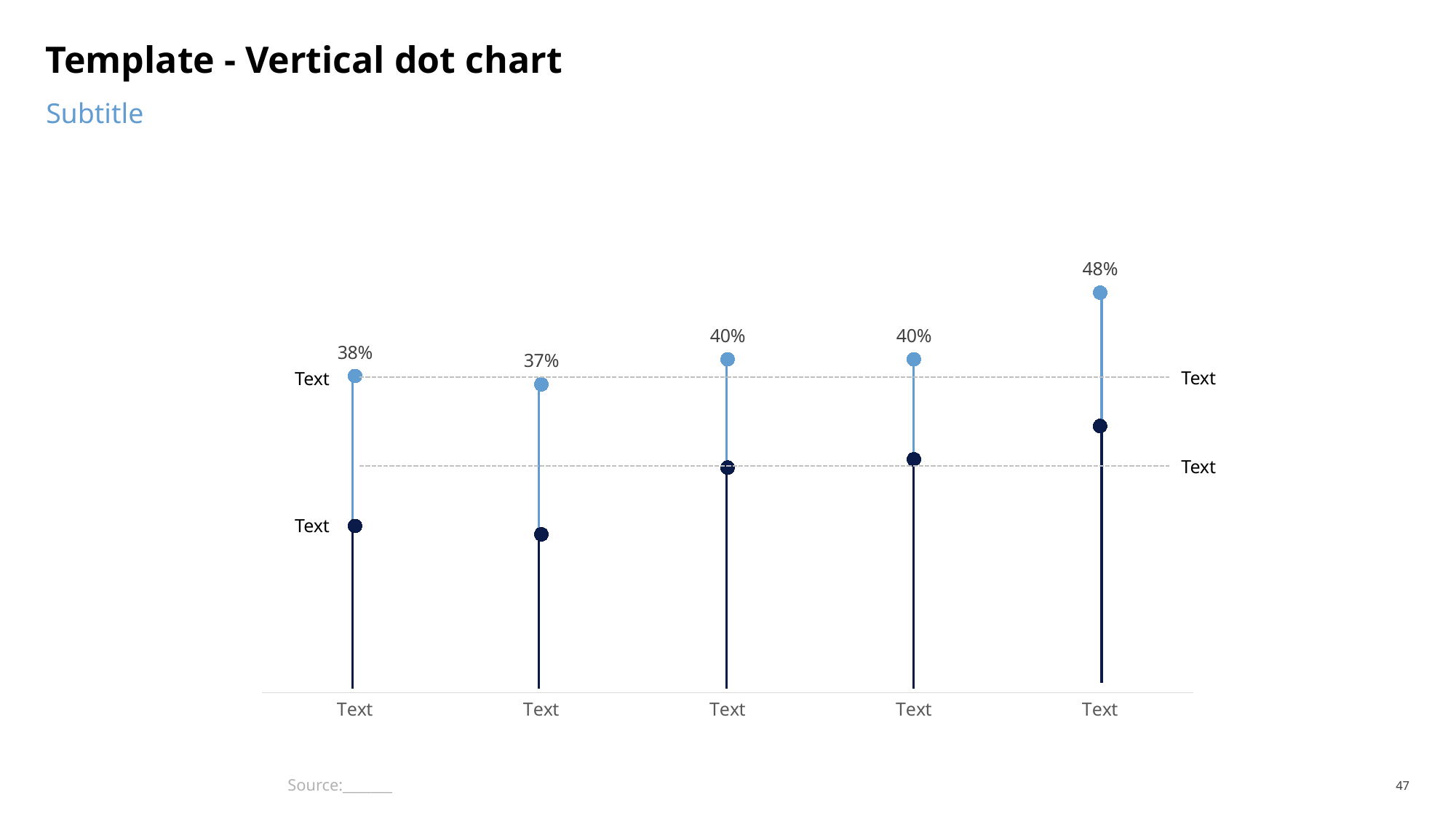
What is the difference between the highest labelled value (48%) and the lowest labelled value (37%)? 11 percentage points What is the labelled value of the light blue dot for the leftmost category? 38% How many dots are plotted for each category? 2 Which category has the highest labelled light blue value? The rightmost category (48%) What is the labelled value of the light blue dot for the second category from the left? 37% Which is larger, the labelled value for the leftmost category or the labelled value for the second category from the left? The leftmost category (38%) What kind of chart is shown on the slide? Vertical dot chart What is the labelled value of the light blue dot for the middle (third) category? 40% What is the labelled value of the light blue dot for the rightmost category? 48% How many categories are plotted along the x axis? 5 Which category has the lowest labelled light blue value? The second category from the left (37%) What is the title of the chart slide? Template - Vertical dot chart